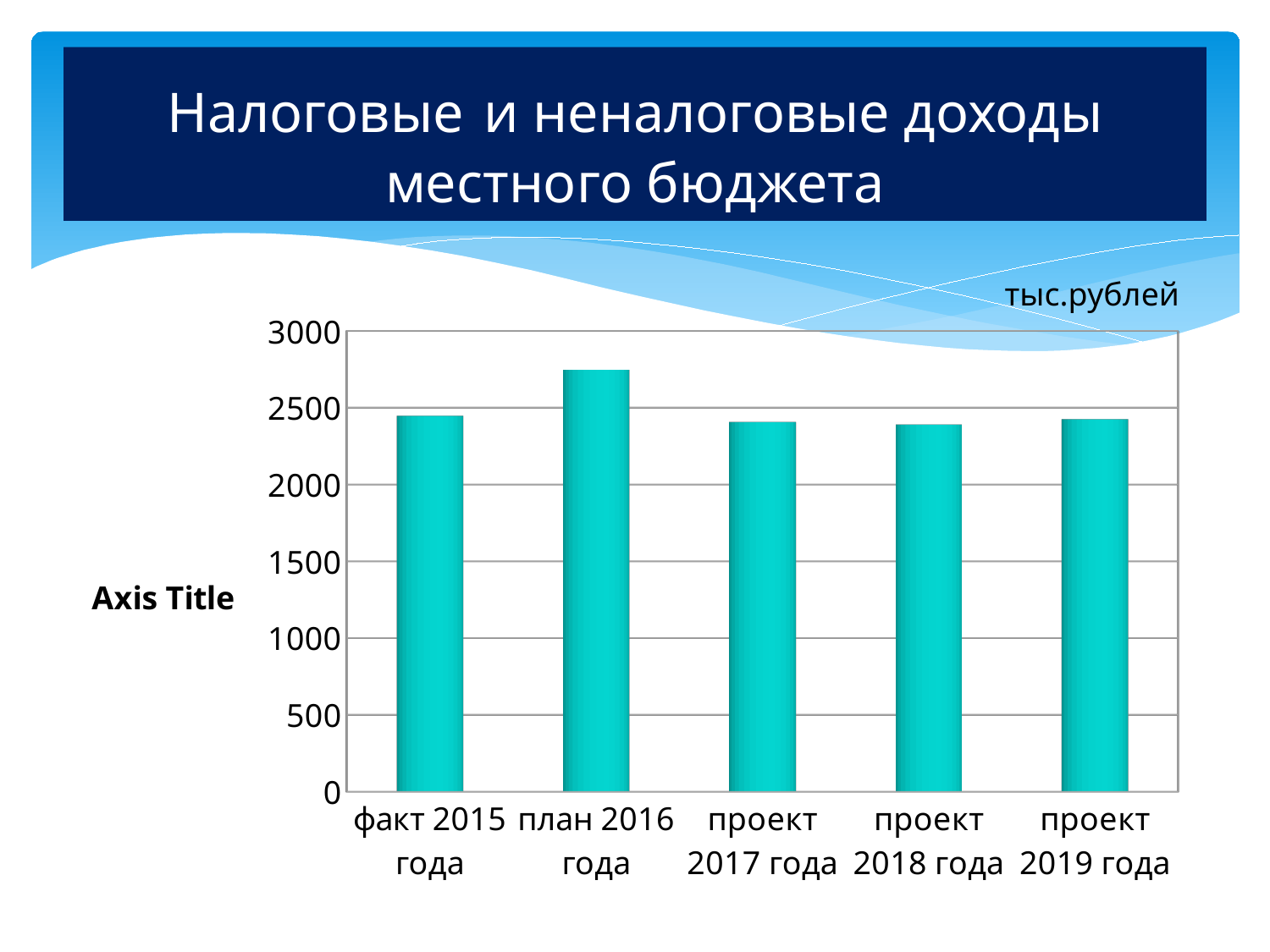
How many categories are shown on the x axis of the chart? 5 Is the value for план 2016 года greater or less than 2500? greater What unit is indicated above the chart? тыс.рублей What kind of chart is shown on the slide? bar chart What is the title of the slide containing the chart? Налоговые и неналоговые доходы местного бюджета Which category has the highest bar in the chart? план 2016 года Is the value for проект 2017 года greater or less than 2000? greater Which is larger, the value for план 2016 года or the value for проект 2017 года? план 2016 года Which is larger, the value for факт 2015 года or the value for план 2016 года? план 2016 года Is the value for проект 2018 года greater or less than 2500? less